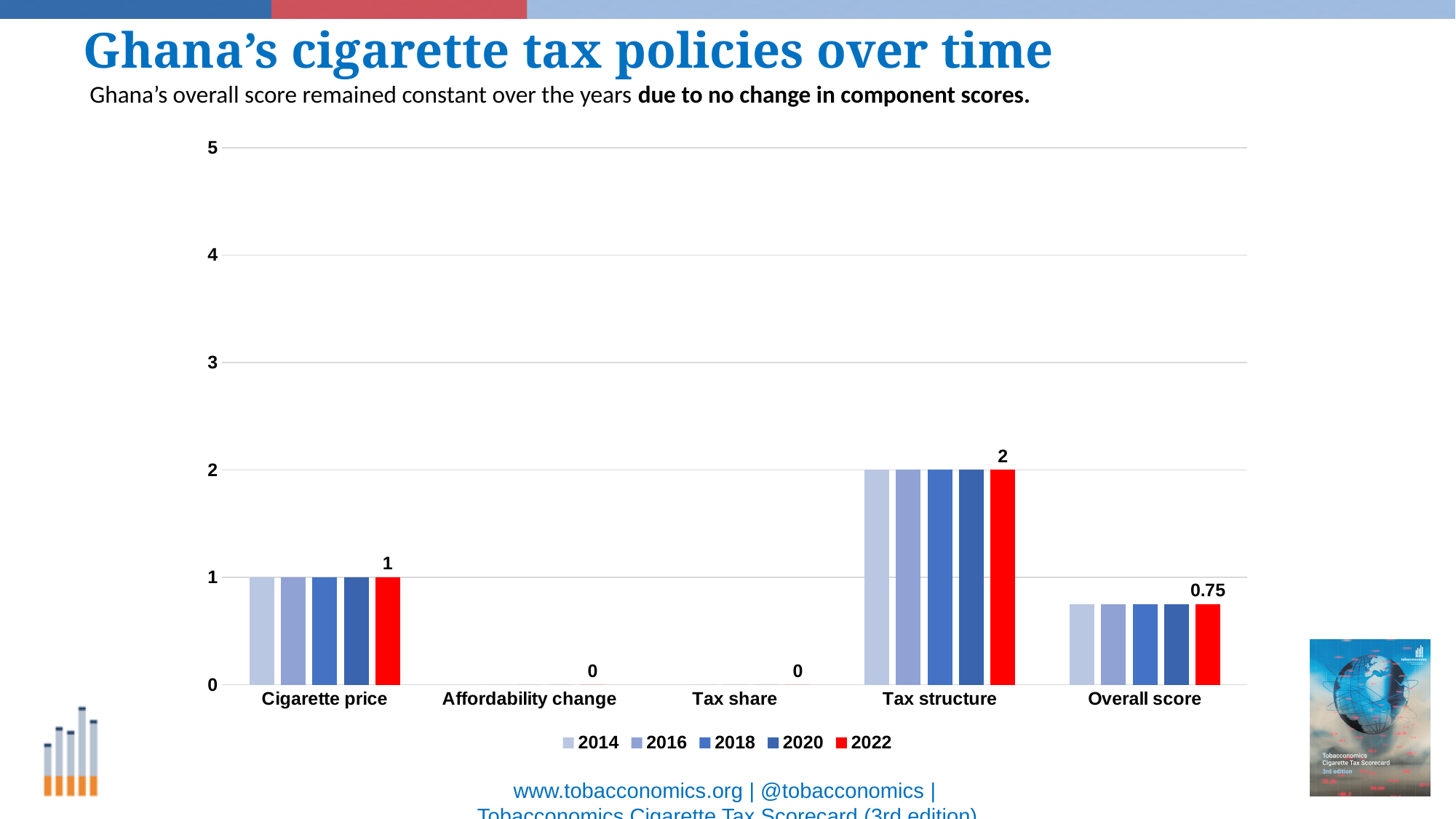
What is the 2022 value for Tax structure? 2 Which category has the highest 2022 value? Tax structure Which is larger in 2022: Cigarette price or Overall score? Cigarette price What is the 2022 value for Cigarette price? 1 What is the 2014 value for Tax structure? 2 What is the 2022 value for Affordability change? 0 What is the 2022 value for Overall score? 0.75 How many series does the legend list? 5 Is the 2014 value for Overall score greater or less than 1? less How many categories are shown on the x axis? 5 What kind of chart is shown on the slide? bar chart What is the difference between the 2022 values for Tax structure and Cigarette price? 1